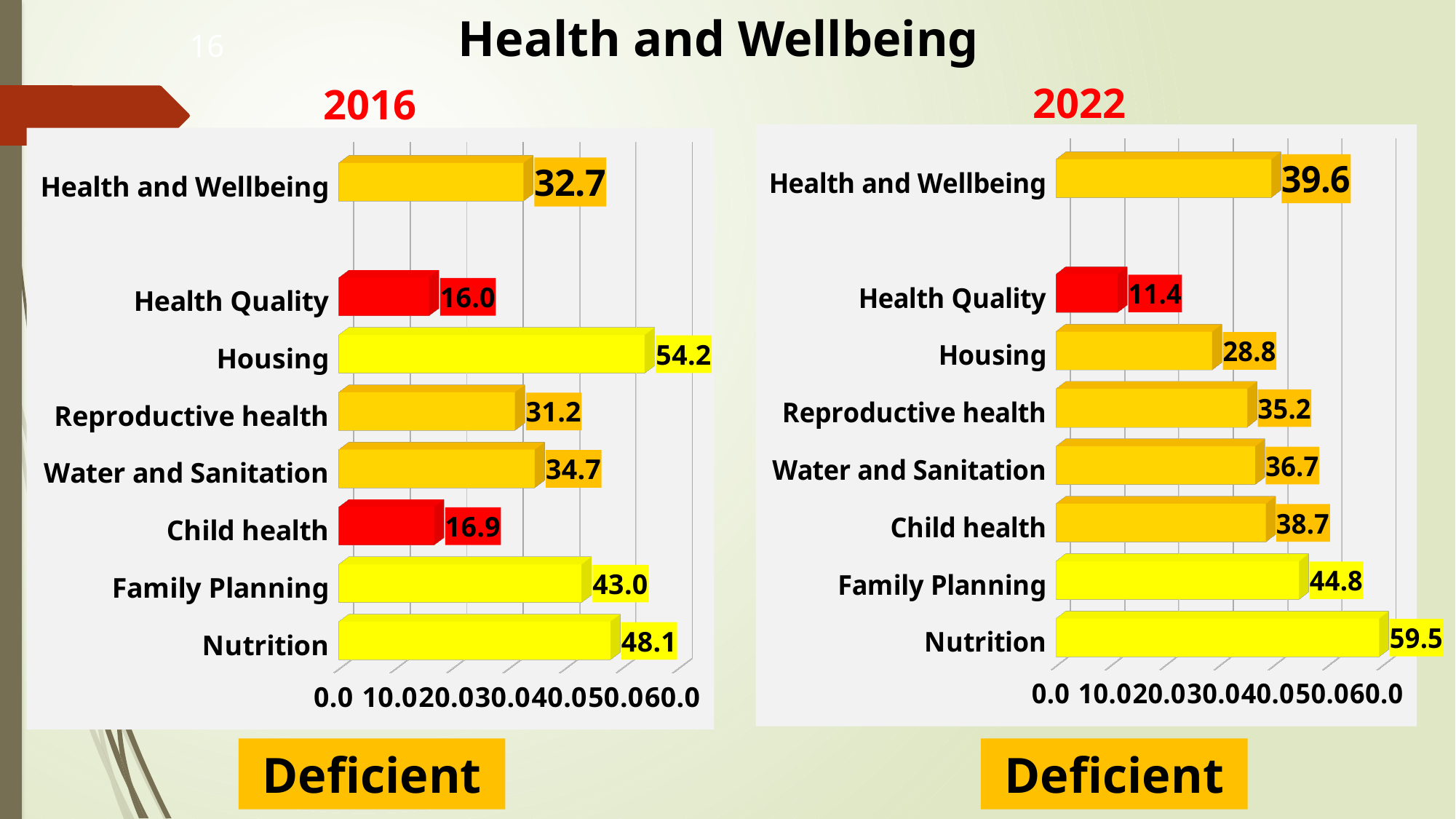
In the 2022 chart, what is the difference between Nutrition and Family Planning? 14.7 In the 2016 chart, which category has the highest value? Housing In the 2016 chart, what colour are the bars for Health Quality and Child health? red In the 2016 chart, what is the difference between Housing and Child health? 37.3 In the 2016 chart, what is the value for Housing? 54.2 In the 2016 chart, what is the value for Health Quality? 16.0 In the 2016 chart, which is larger, Family Planning or Water and Sanitation? Family Planning In the 2022 chart, which category has the lowest value? Health Quality In the 2022 chart, is the value for Housing greater or less than 30.0? less In the 2022 chart, what is the value for Nutrition? 59.5 What type of chart is the 2016 chart? bar chart How many categories are shown in the 2022 chart? 8